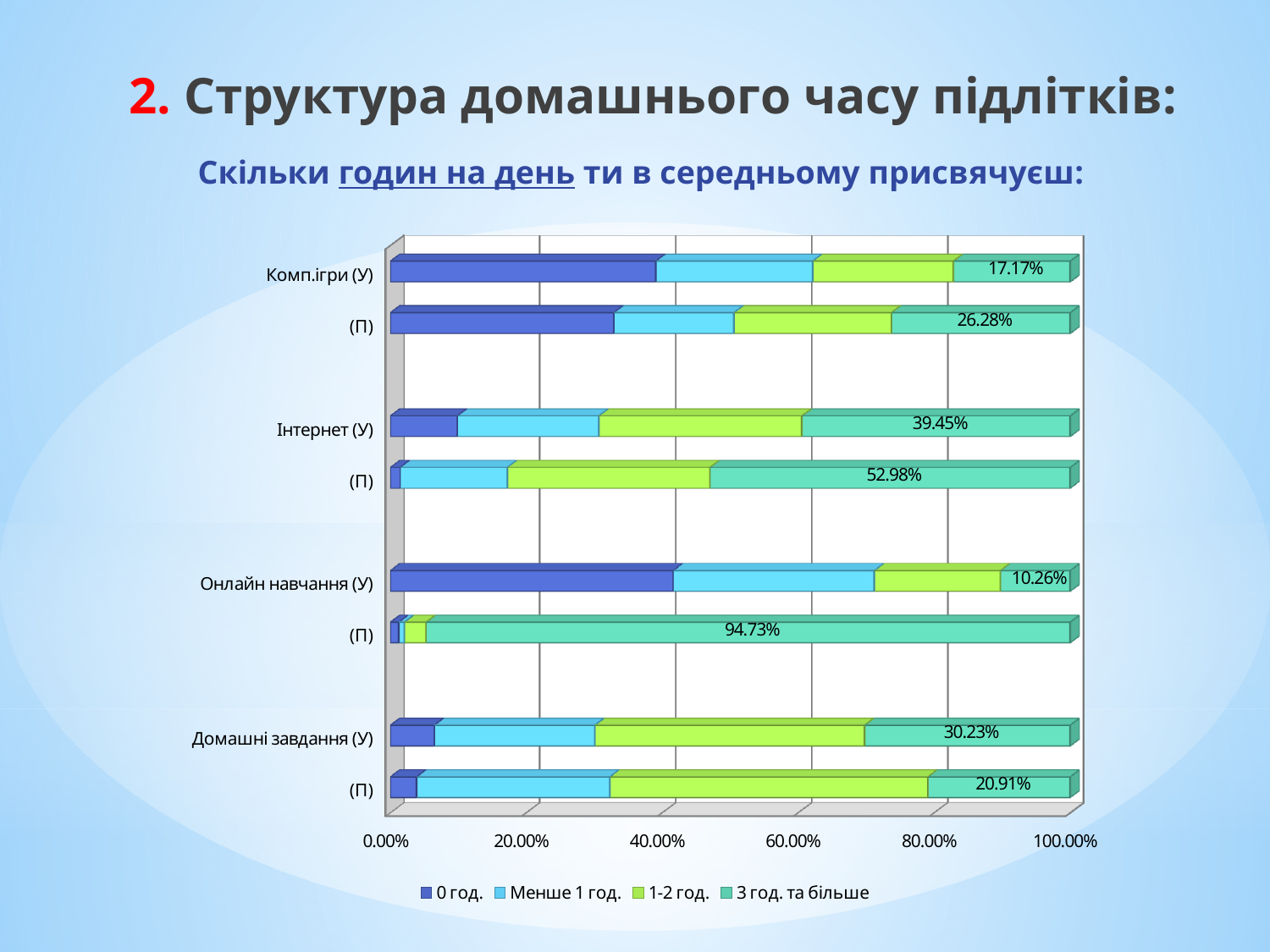
What is the difference between the '3 год. та більше' values for Інтернет (П) and Інтернет (У)? 13.53% Which is larger for '3 год. та більше': Комп.ігри (П) or Домашні завдання (П)? Комп.ігри (П) Is the '0 год.' value for Комп.ігри (У) greater or less than 20.00%? greater What is the value of the '3 год. та більше' series for Комп.ігри (У)? 17.17% Which category has the lowest labelled value for '3 год. та більше'? Онлайн навчання (У) What is the value of the '3 год. та більше' series for Онлайн навчання (П)? 94.73% How many series does the legend list? 4 What is the value of the '3 год. та більше' series for Інтернет (П)? 52.98% Which category has the highest labelled value for '3 год. та більше'? Онлайн навчання (П) How many categories are shown on the vertical axis of the chart? 8 What kind of chart is shown on the slide? Stacked bar chart What is the value of the '3 год. та більше' series for Домашні завдання (У)? 30.23%